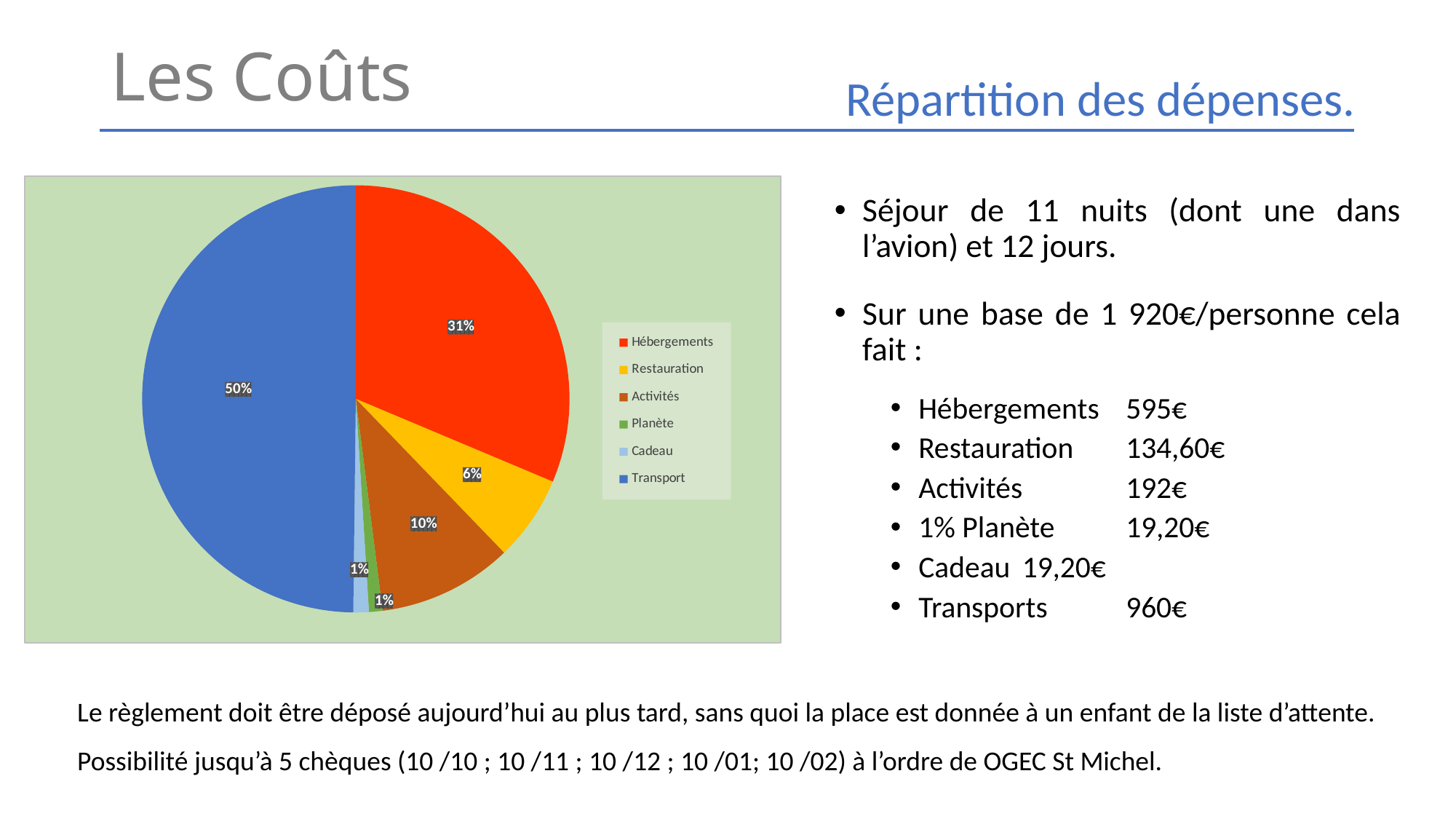
What share of the pie does Transport represent? 50% What share of the pie does Activités represent? 10% What kind of chart is shown on the slide? pie chart How many categories does the pie chart legend list? 6 Which legend entry is shown in red? Hébergements What share of the pie does Restauration represent? 6% What share of the pie does Hébergements represent? 31% Which category has the largest slice of the pie? Transport What colour is the Transport slice in the pie chart? blue What is the difference in percentage points between the Transport slice and the Hébergements slice? 19 What share of the pie does Cadeau represent? 1% Which slice is larger, Activités or Restauration? Activités